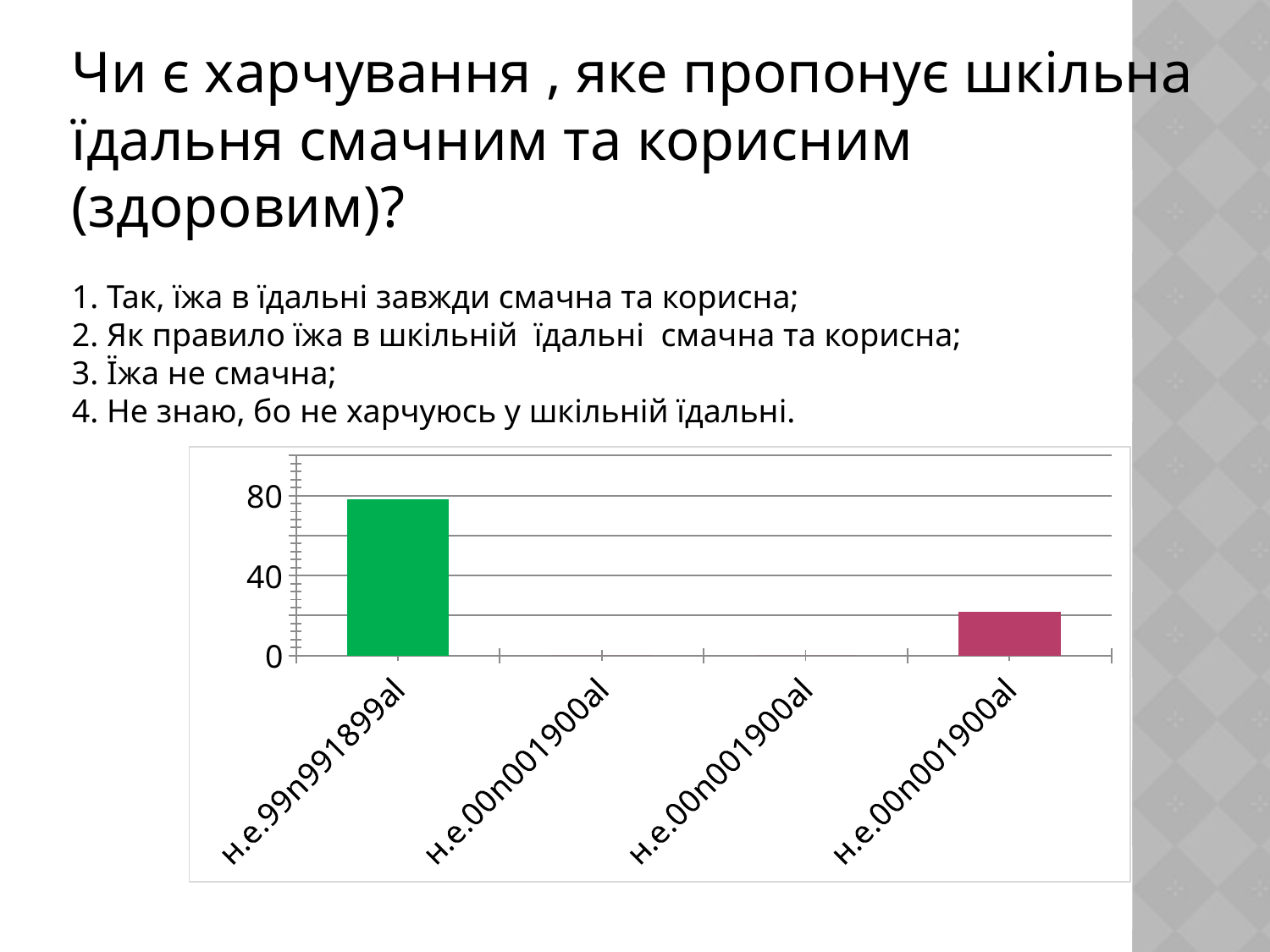
Which is larger, the first bar or the fourth (rightmost) bar? the first bar How many of the four categories have a visible bar above zero? 2 What kind of chart is shown on the slide? bar chart Is the value of the first bar (н.е.99n991899al) greater or less than 40? greater What colour is the first (tallest) bar in the chart? green Is the value of the fourth (rightmost) bar greater or less than 40? less Do the values rise or fall from the first bar to the fourth bar? fall Which bar is the highest in the chart? the first bar (н.е.99n991899al) What is the highest value labelled on the vertical axis? 80 How many categories are shown on the x axis of the chart? 4